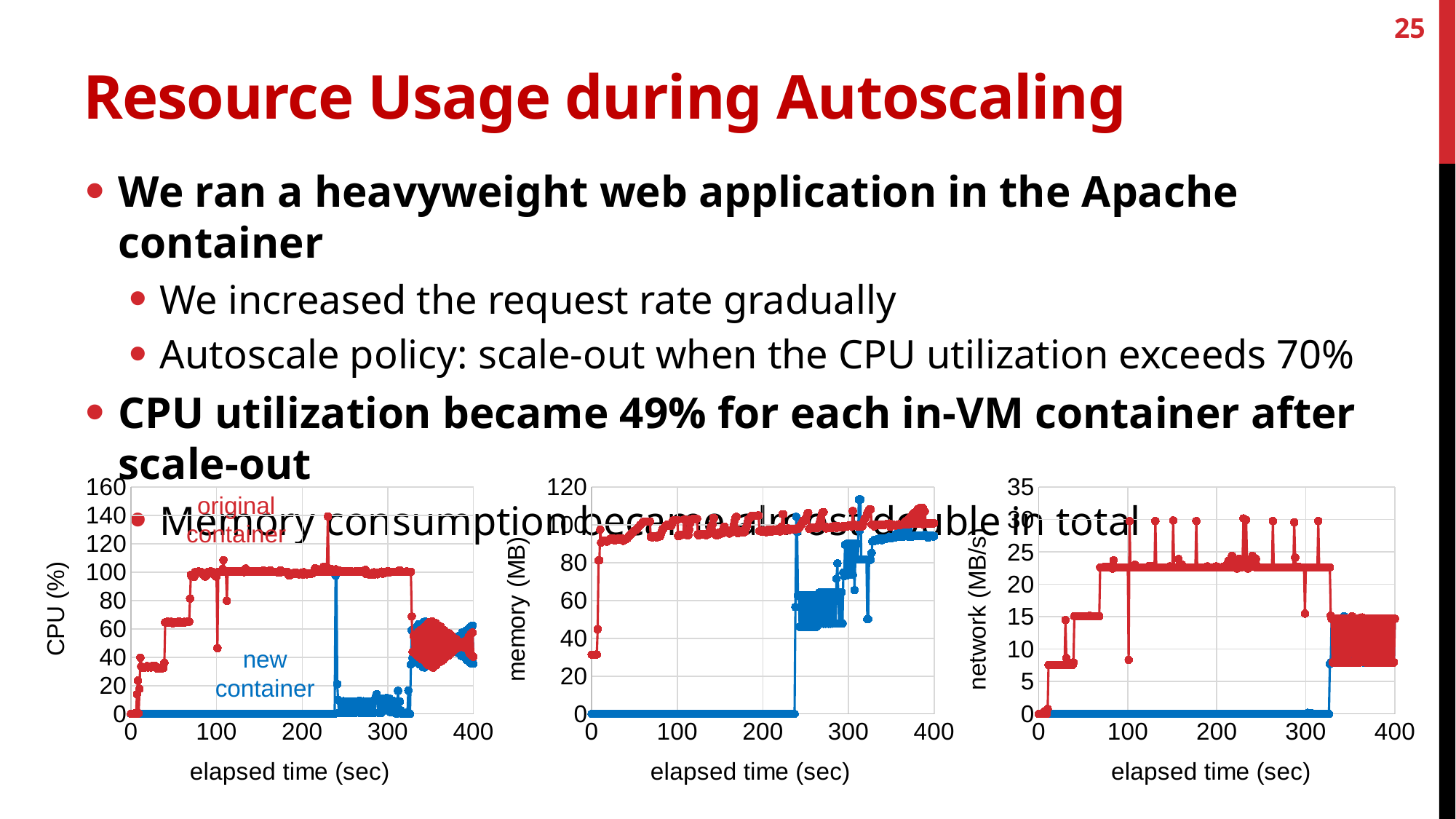
In the CPU (%) chart, which colour represents the new container? blue In the CPU (%) chart, is the value for the original container at 150 sec greater or less than 80? greater In the CPU (%) chart, does the original container's CPU usage rise or fall between 0 and 100 sec? rise In the network (MB/s) chart, is the value for the original container at 200 sec greater or less than 20? greater In the CPU (%) chart, how many series are labelled? 2 In the memory (MB) chart, is the value for the original container at 100 sec greater or less than 80? greater What is the y-axis label of the middle chart? memory (MB) How many charts are shown on the slide? 3 What kind of chart is the leftmost chart (CPU (%) vs elapsed time)? line chart